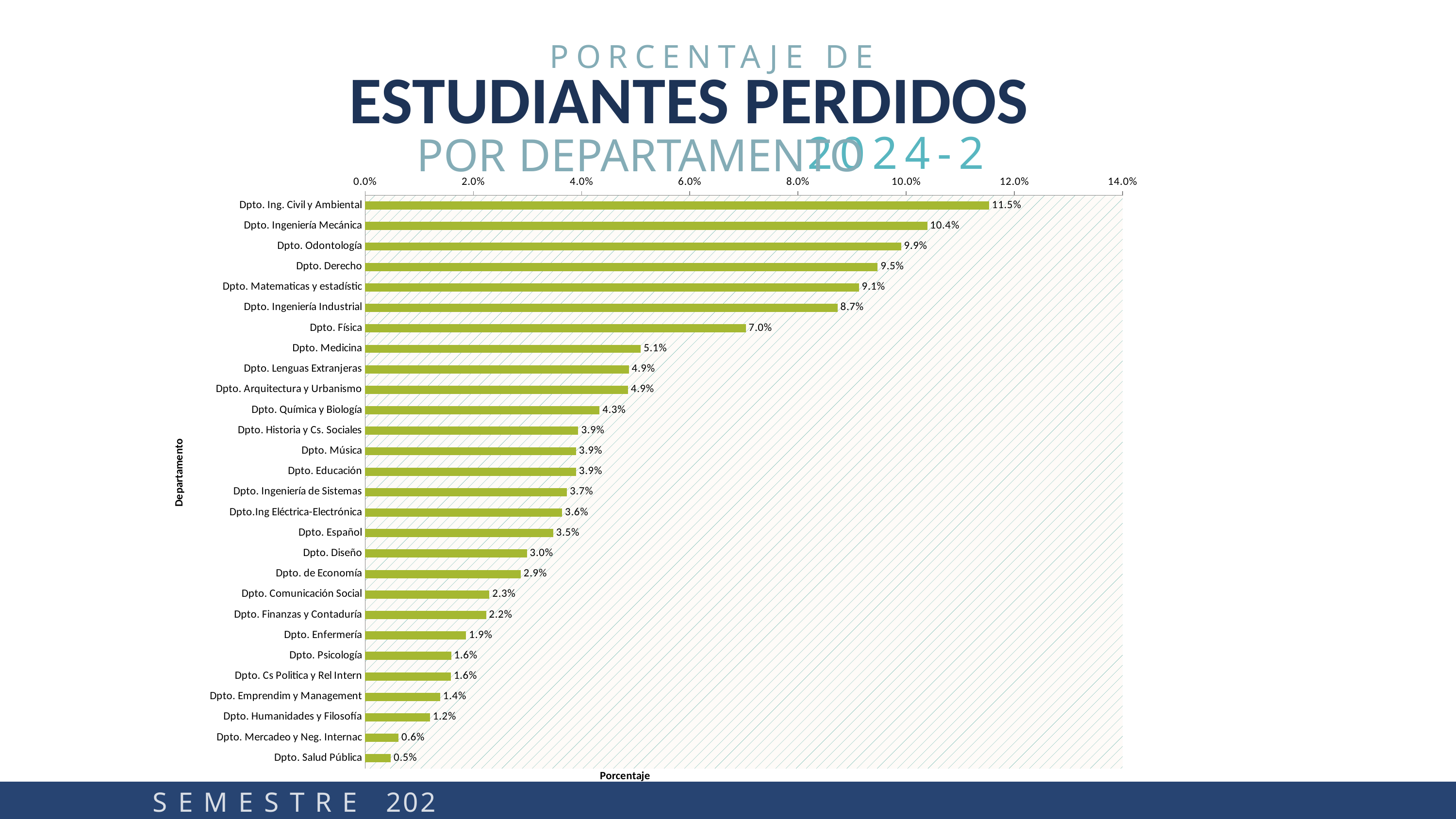
What is the difference between Dpto. Derecho and Dpto. Diseño? 6.5% What is the value for Dpto. Física? 7.0% What is the value for Dpto. Medicina? 5.1% What is the value for Dpto. Ing. Civil y Ambiental? 11.5% Which department has the lowest percentage? Dpto. Salud Pública Which is larger, the value for Dpto. Ingeniería Industrial or Dpto. Química y Biología? Dpto. Ingeniería Industrial What is the label of the horizontal axis? Porcentaje What is the value for Dpto. Enfermería? 1.9% How many departments are shown in the chart? 28 Which department has the highest percentage? Dpto. Ing. Civil y Ambiental What kind of chart is shown on the slide? Bar chart What is the difference between Dpto. Ingeniería Mecánica and Dpto. Odontología? 0.5%